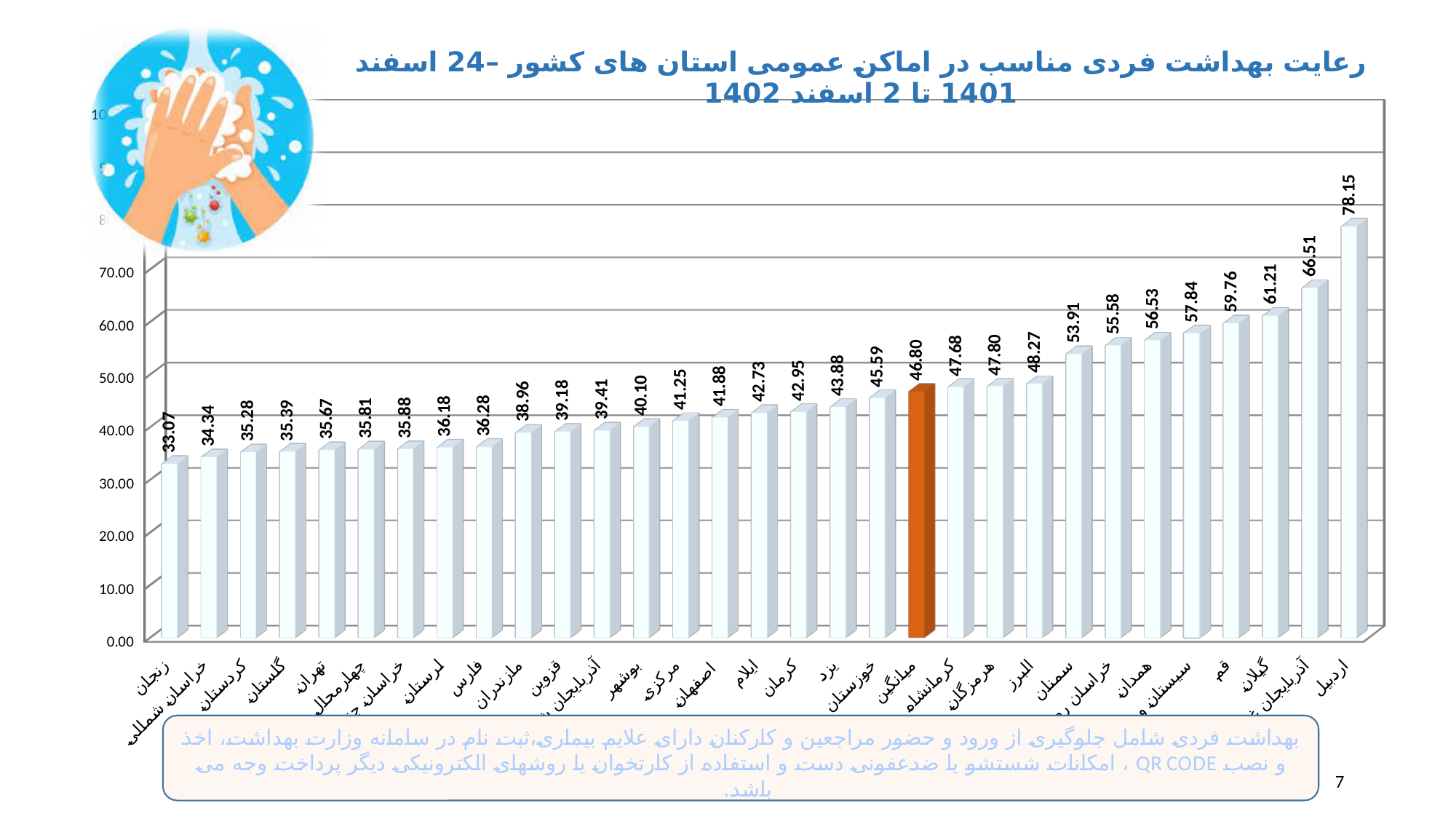
What is the difference between the values for اردبیل and زنجان? 45.08 What is the value of the میانگین (average) bar? 46.80 Which province has the highest value? اردبیل What is the value for تهران? 35.67 What is the value for اردبیل? 78.15 How many bars are plotted in the chart? 31 Which province has the lowest value? زنجان Which has a larger value, گیلان or قم? گیلان What kind of chart is shown on the slide? bar chart Which bar is highlighted in a different colour (orange) from the others? میانگین Is the value for همدان greater or less than 50.00? greater Do the values rise or fall from left to right along the x axis? rise